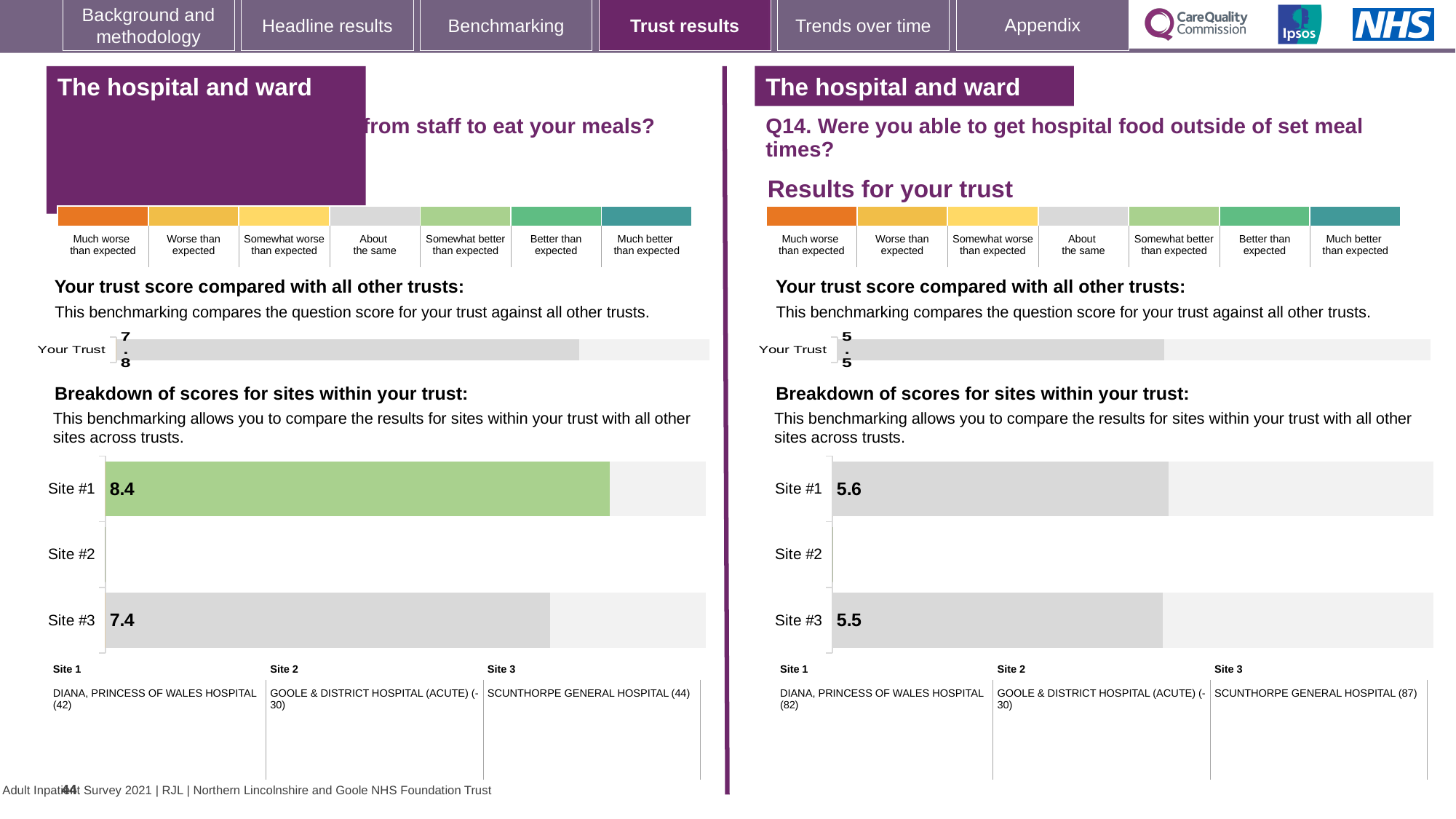
In the right-hand site breakdown chart for Q14, what is the score for Site #1? 5.6 In the right-hand site breakdown chart for Q14, what is the score for Site #3? 5.5 In the left-hand site breakdown chart, is the Site #1 score larger than the Site #3 score? Yes, Site #1 On the left-hand chart (question about help from staff to eat your meals), what is the 'Your Trust' score? 7.8 What type of chart is used for the site breakdown of scores on the slide? Bar chart In the left-hand site breakdown chart, what is the score for Site #1? 8.4 How many site categories are listed in the right-hand site breakdown chart for Q14? 3 In the left-hand site breakdown chart, what is the score for Site #3? 7.4 In the right-hand site breakdown chart for Q14, what is the difference between the Site #1 and Site #3 scores? 0.1 In the left-hand site breakdown chart, what is the difference between the Site #1 and Site #3 scores? 1.0 On the right-hand chart for Q14 (hospital food outside of set meal times), what is the 'Your Trust' score? 5.5 In the left-hand site breakdown chart, which site has the highest score? Site #1